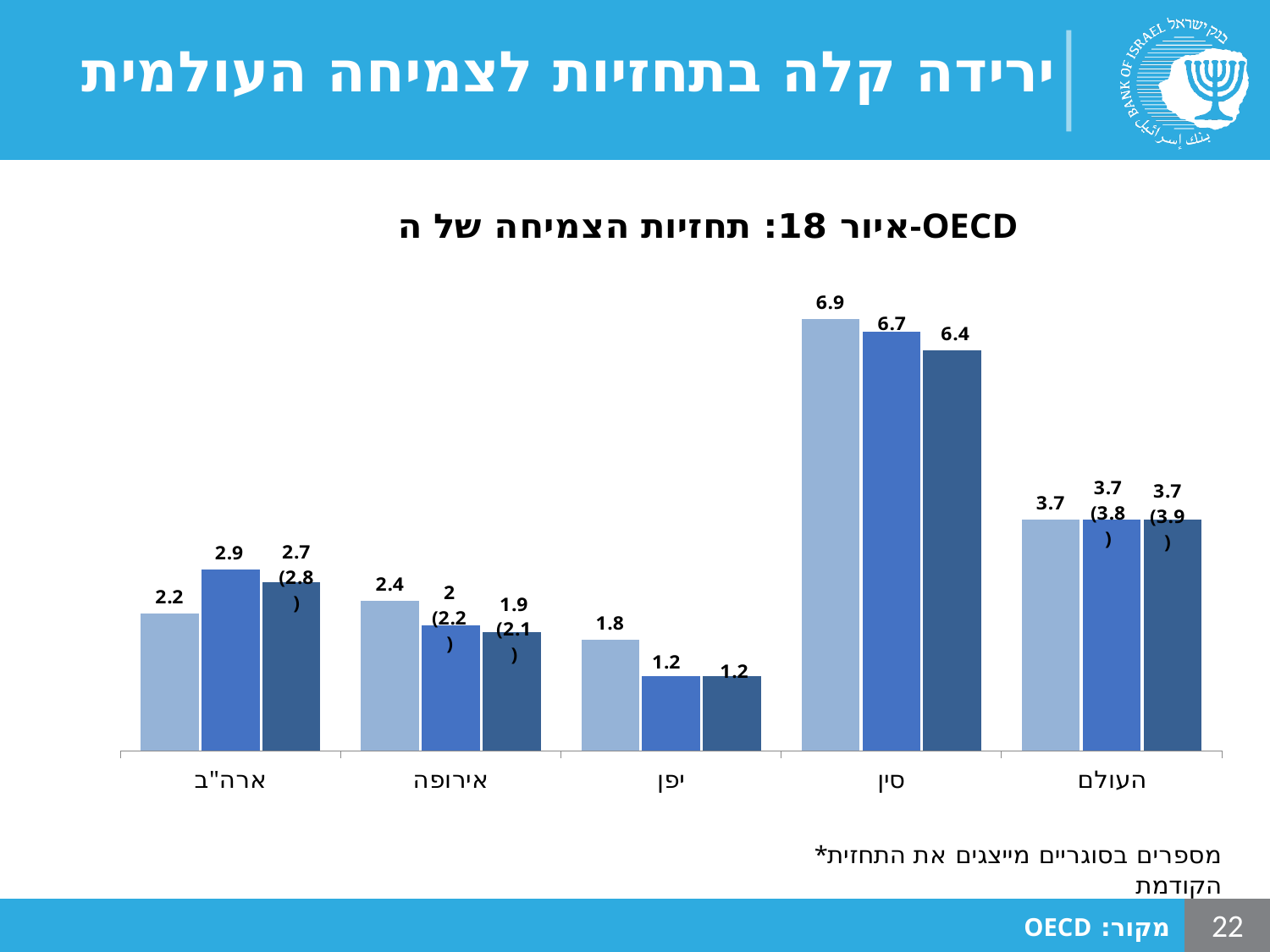
What is the value of the lightest (leftmost) bar for סין (China)? 6.9 How many bars are plotted for each category in the chart? 3 What is the figure number given in the chart title? 18 What is the value of the lightest (leftmost) bar for אירופה (Europe)? 2.4 What type of chart is shown on the slide? bar chart Which category has the lowest values in the chart? יפן Which category has the highest values in the chart? סין Which is larger: the lightest bar for ארה"ב (USA) or the lightest bar for אירופה (Europe)? אירופה (2.4) What is the value of the middle bar for ארה"ב (USA)? 2.9 What is the difference between the lightest bar and the darkest bar for סין (China)? 0.5 How many categories are shown on the x axis of the chart? 5 What is the value of the darkest (rightmost) bar for יפן (Japan)? 1.2